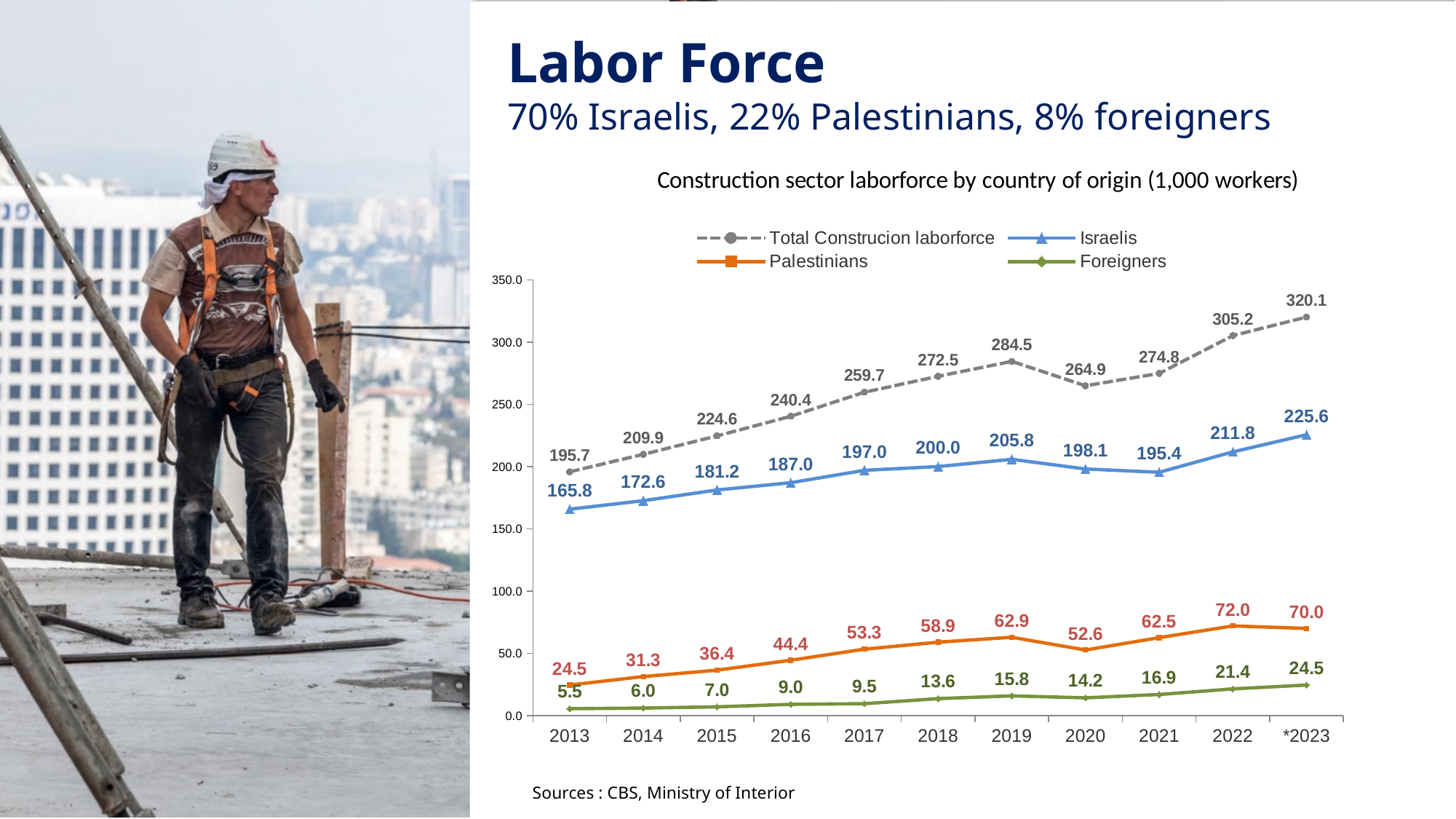
What is the difference between the Total Construcion laborforce values in 2019 and 2020? 19.6 How many series does the legend list? 4 Which is larger: the Palestinians value in 2019 or in 2021? 2019 What is the value for Foreigners in 2018? 13.6 What is the value for Palestinians in 2016? 44.4 How many years are plotted on the x axis? 11 What is the Total Construcion laborforce value in 2020? 264.9 What is the value for Israelis in 2017? 197.0 In which year is the Foreigners series at its lowest? 2013 By how much did the Israelis value increase from 2013 to *2023? 59.8 What kind of chart is shown on the slide? Line chart In which year is the Palestinians series at its highest? 2022